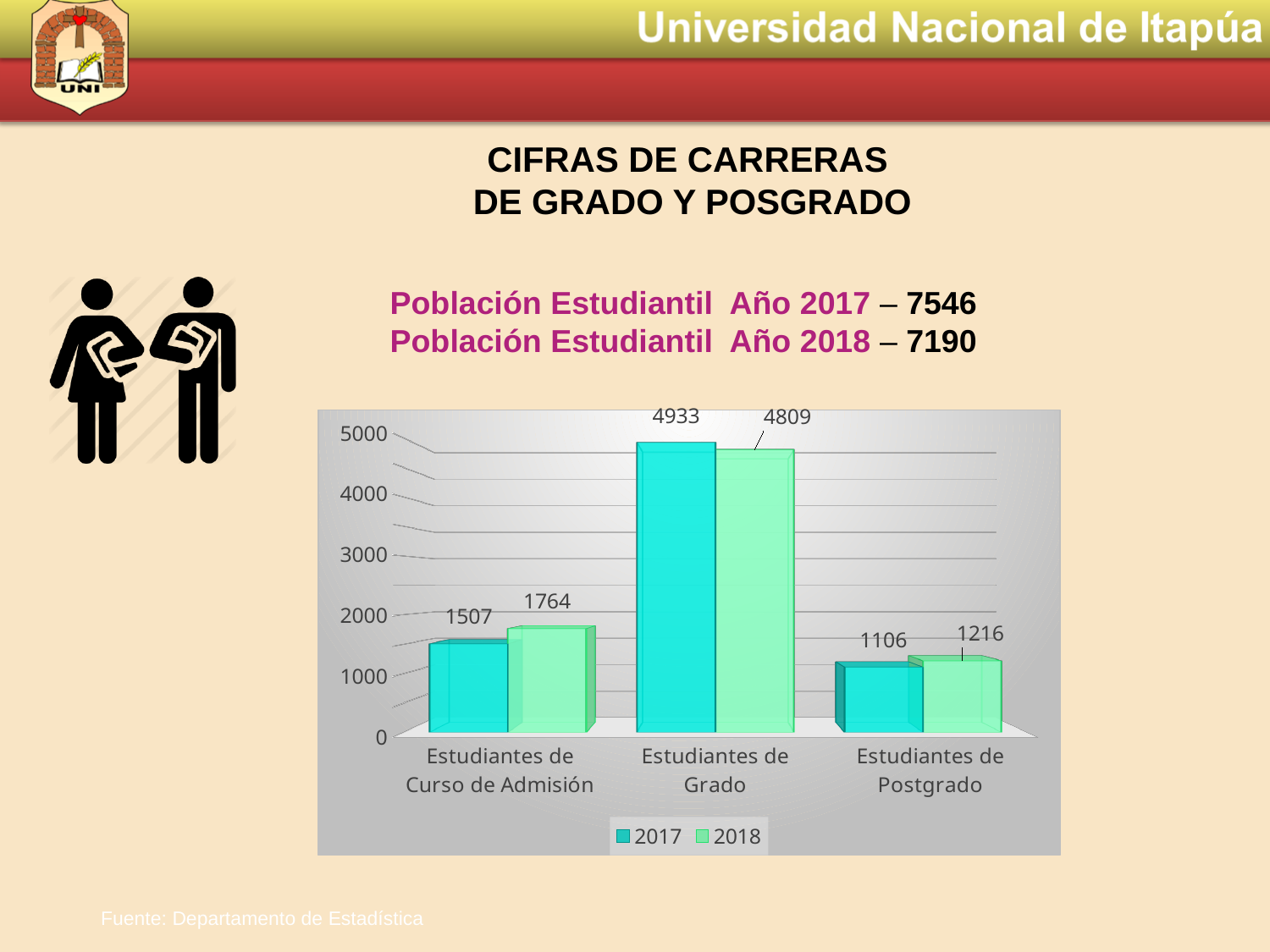
Which category has the lowest value in 2017? Estudiantes de Postgrado How many categories are shown on the x axis? 3 Is the 2017 value for Estudiantes de Grado greater or less than 4000? greater What is the value for Estudiantes de Postgrado in 2017? 1106 What kind of chart is shown on the slide? bar chart What is the difference between the 2017 and 2018 values for Estudiantes de Grado? 124 What is the value for Estudiantes de Grado in 2017? 4933 How many series does the legend list? 2 What is the difference between the 2018 and 2017 values for Estudiantes de Curso de Admisión? 257 What is the value for Estudiantes de Curso de Admisión in 2018? 1764 Which category has the highest value in 2018? Estudiantes de Grado Which is larger for Estudiantes de Postgrado, the 2017 value or the 2018 value? 2018